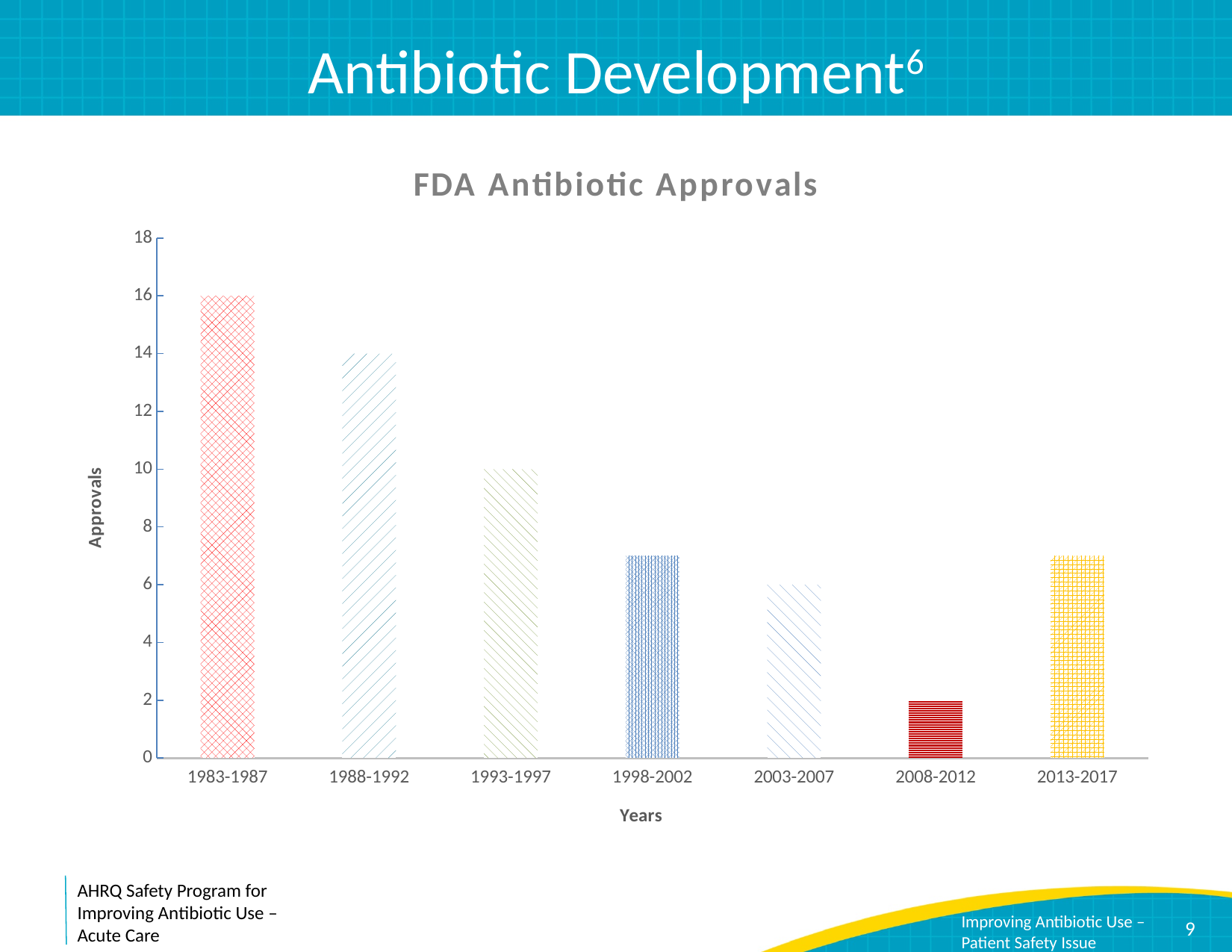
What kind of chart is shown on the slide? bar chart How many approvals are shown for 1988-1992? 14 What is the difference between the values for 1983-1987 and 1988-1992? 2 What is the value for 2008-2012? 2 Which is larger, the value for 1988-1992 or the value for 1993-1997? 1988-1992 What is the value for 1983-1987 in the FDA Antibiotic Approvals chart? 16 How many year periods are shown on the x axis? 7 Is the value for 1998-2002 greater or less than 8? less What is the label of the y axis? Approvals What is the difference between the values for 1993-1997 and 2003-2007? 4 Which period has the lowest number of approvals? 2008-2012 Which period has the highest number of approvals? 1983-1987